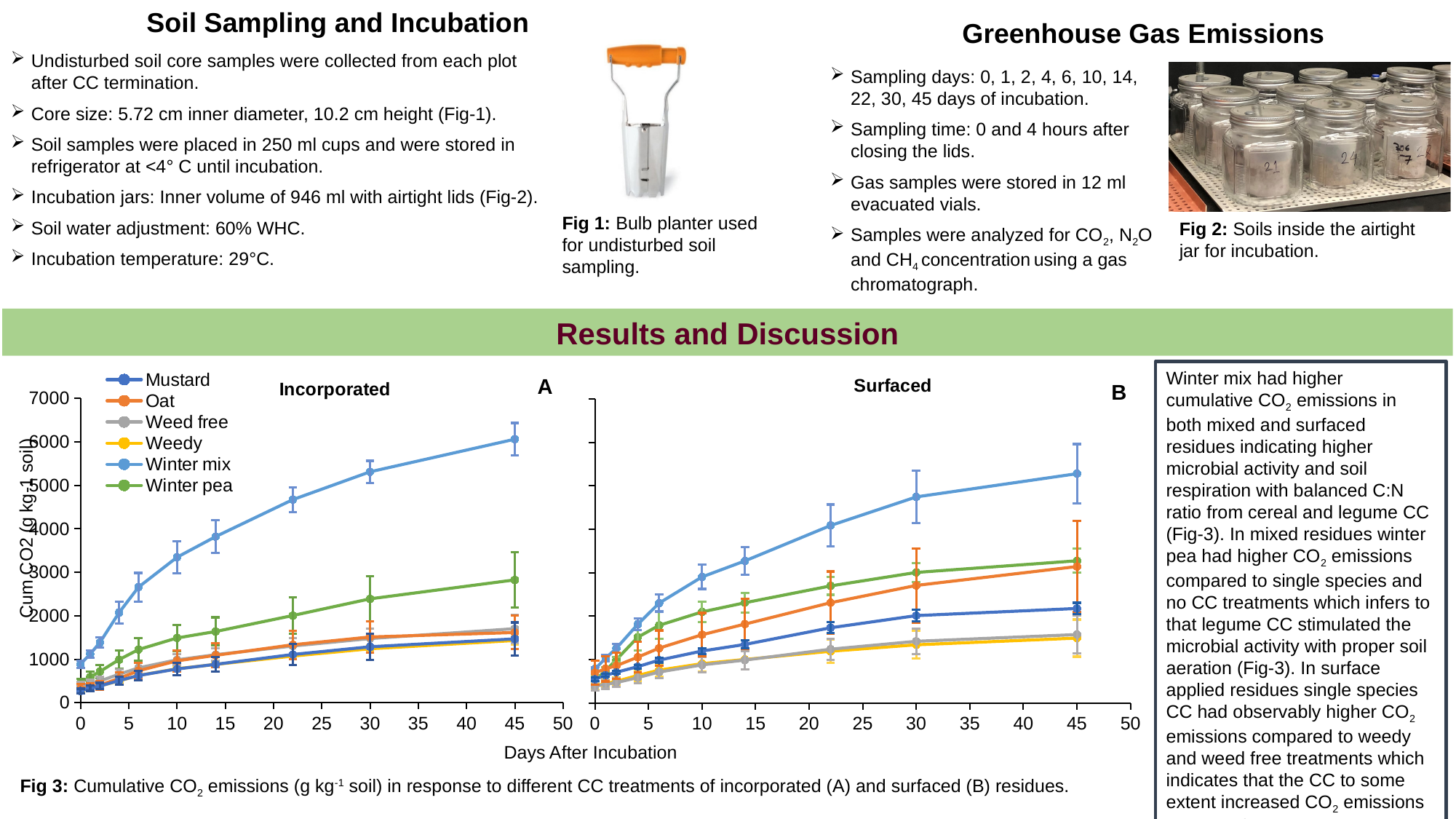
In the Incorporated (A) chart, is the Winter mix value at day 45 greater or less than 5000? greater In the Surfaced (B) chart, does the Winter mix series rise or fall as days after incubation increase? rise How many series does the legend list for the Fig 3 charts? 6 How many time points are plotted for each series in the Incorporated (A) chart? 10 In the Surfaced (B) chart, which is larger at day 45: Oat or Mustard? Oat In the Surfaced (B) chart, which treatment has the highest cumulative CO2 at day 45? Winter mix In the Incorporated (A) chart, is the Winter pea value at day 45 greater or less than 3000? less In the Incorporated (A) chart, which treatment has the highest cumulative CO2 at day 45? Winter mix In the Incorporated (A) chart, which is larger at day 45: Winter pea or Mustard? Winter pea What kind of chart is the Incorporated (A) chart? line chart What is the x-axis title shared by the Fig 3 charts? Days After Incubation In the Surfaced (B) chart, is the Winter mix value at day 30 greater or less than 4000? greater